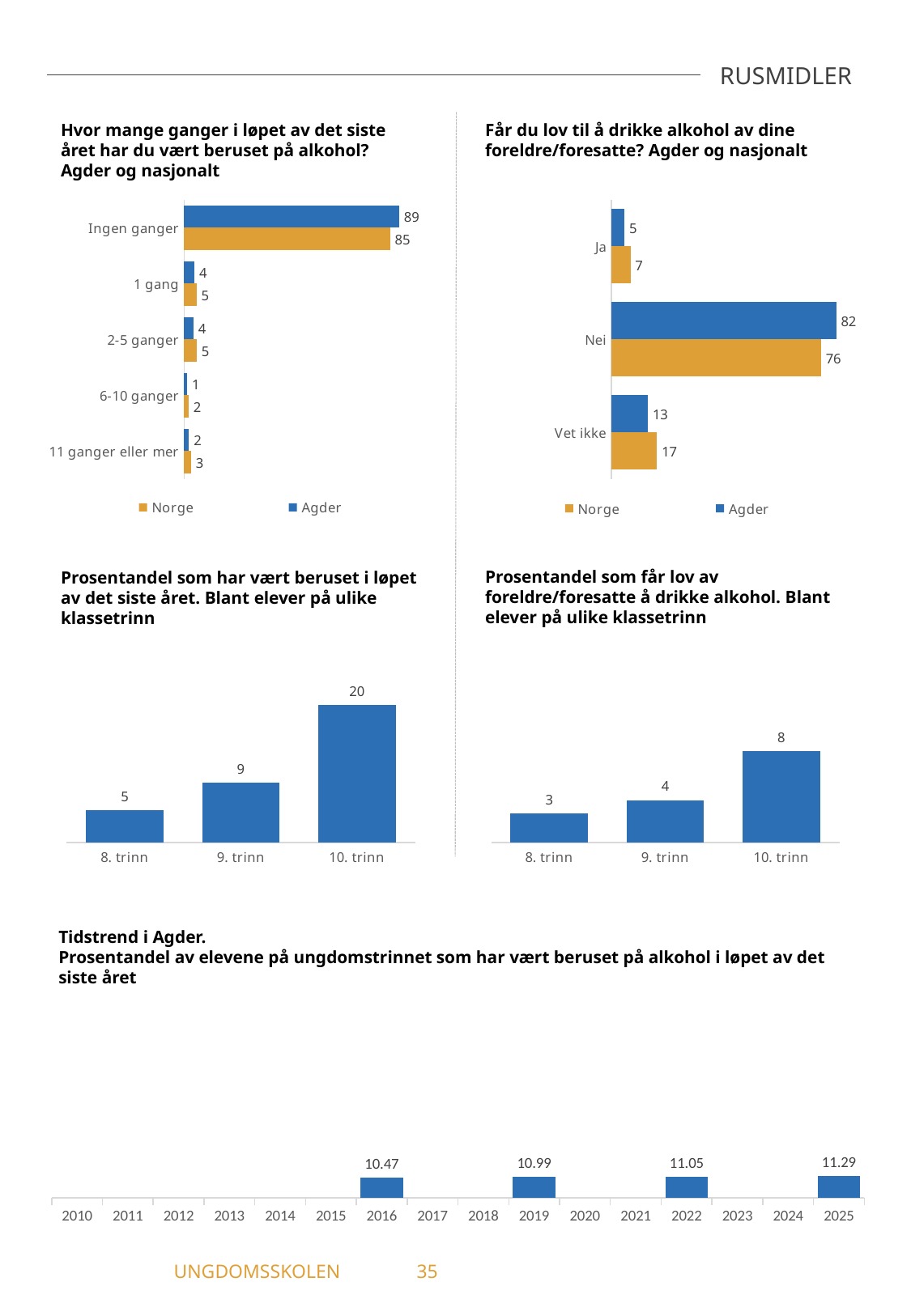
In the middle-left chart 'Prosentandel som har vært beruset i løpet av det siste året', which klassetrinn has the highest value? 10. trinn In the middle-left chart 'Prosentandel som har vært beruset i løpet av det siste året', what is the difference between 10. trinn and 8. trinn? 15 In the top-left chart 'Hvor mange ganger i løpet av det siste året har du vært beruset på alkohol?', how many categories are shown? 5 In the top-right chart 'Får du lov til å drikke alkohol av dine foreldre/foresatte?', what is the difference between Agder and Norge for 'Vet ikke'? 4 In the top-right chart 'Får du lov til å drikke alkohol av dine foreldre/foresatte?', which series has the larger value for 'Ja', Norge or Agder? Norge In the top-right chart 'Får du lov til å drikke alkohol av dine foreldre/foresatte?', what is the value for Norge for 'Nei'? 76 In the top-left chart 'Hvor mange ganger i løpet av det siste året har du vært beruset på alkohol?', what is the value for Norge for '6-10 ganger'? 2 In the bottom chart 'Tidstrend i Agder', do the values rise or fall from 2016 to 2025? rise In the top-left chart 'Hvor mange ganger i løpet av det siste året har du vært beruset på alkohol?', what is the value for Agder for 'Ingen ganger'? 89 In the bottom chart 'Tidstrend i Agder', what is the value for 2025? 11.29 In the middle-right chart 'Prosentandel som får lov av foreldre/foresatte å drikke alkohol', what is the value for 9. trinn? 4 In the top-right chart 'Får du lov til å drikke alkohol av dine foreldre/foresatte?', how many series does the legend list? 2